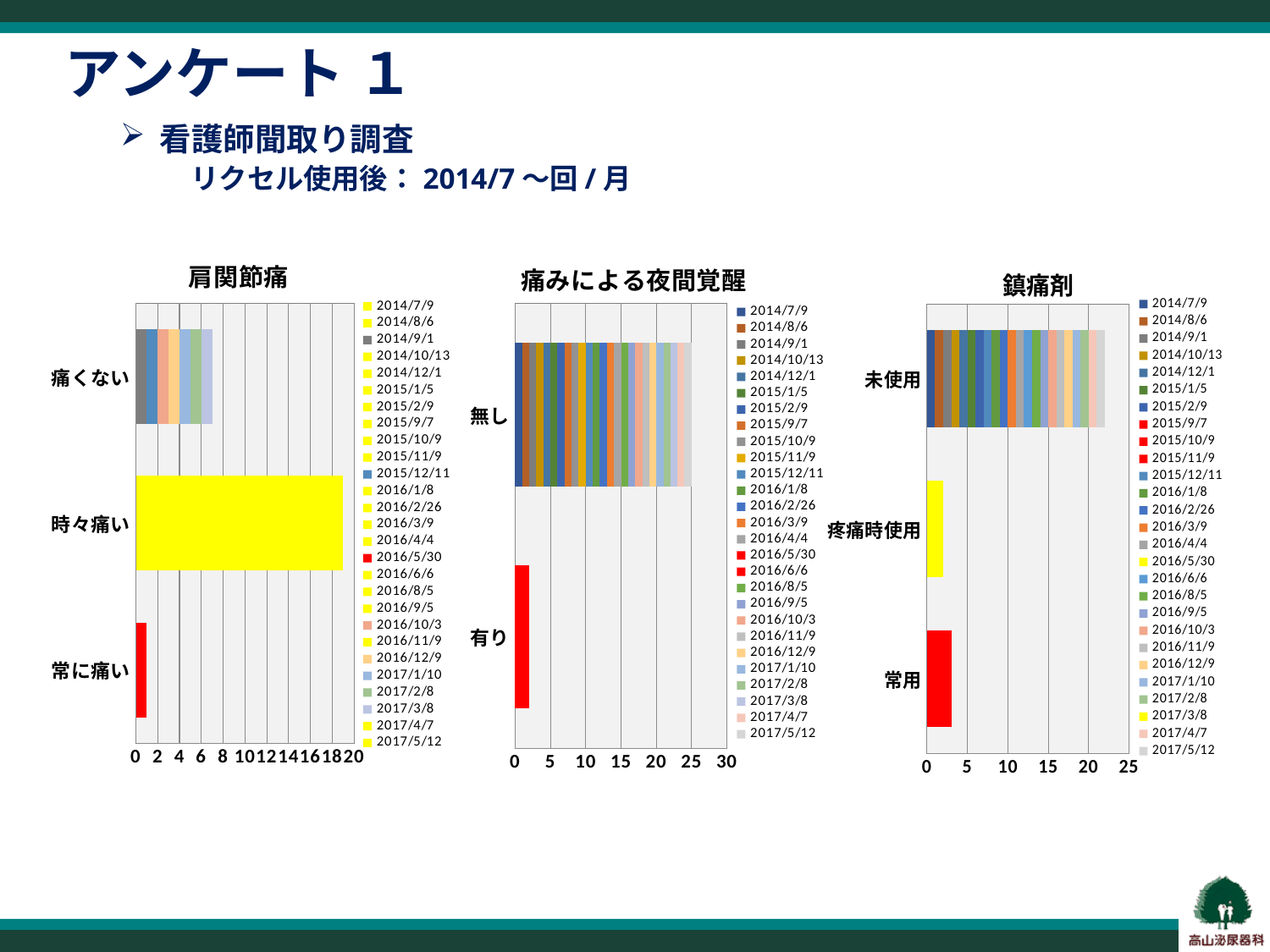
In the 肩関節痛 chart, is the total for 常に痛い greater or less than 2? less How many categories are shown on the y axis of the 鎮痛剤 chart? 3 How many charts are on the slide? 3 In the 痛みによる夜間覚醒 chart, which category has the longer bar, 無し or 有り? 無し In the 肩関節痛 chart, which category has the longest bar? 時々痛い In the 痛みによる夜間覚醒 chart, is the total for 無し greater or less than 20? greater In the 痛みによる夜間覚醒 chart, is the total for 有り greater or less than 5? less In the 鎮痛剤 chart, which category has the longest bar? 未使用 In the 肩関節痛 chart, which category has the shortest bar? 常に痛い What kind of chart is the 肩関節痛 chart? bar chart